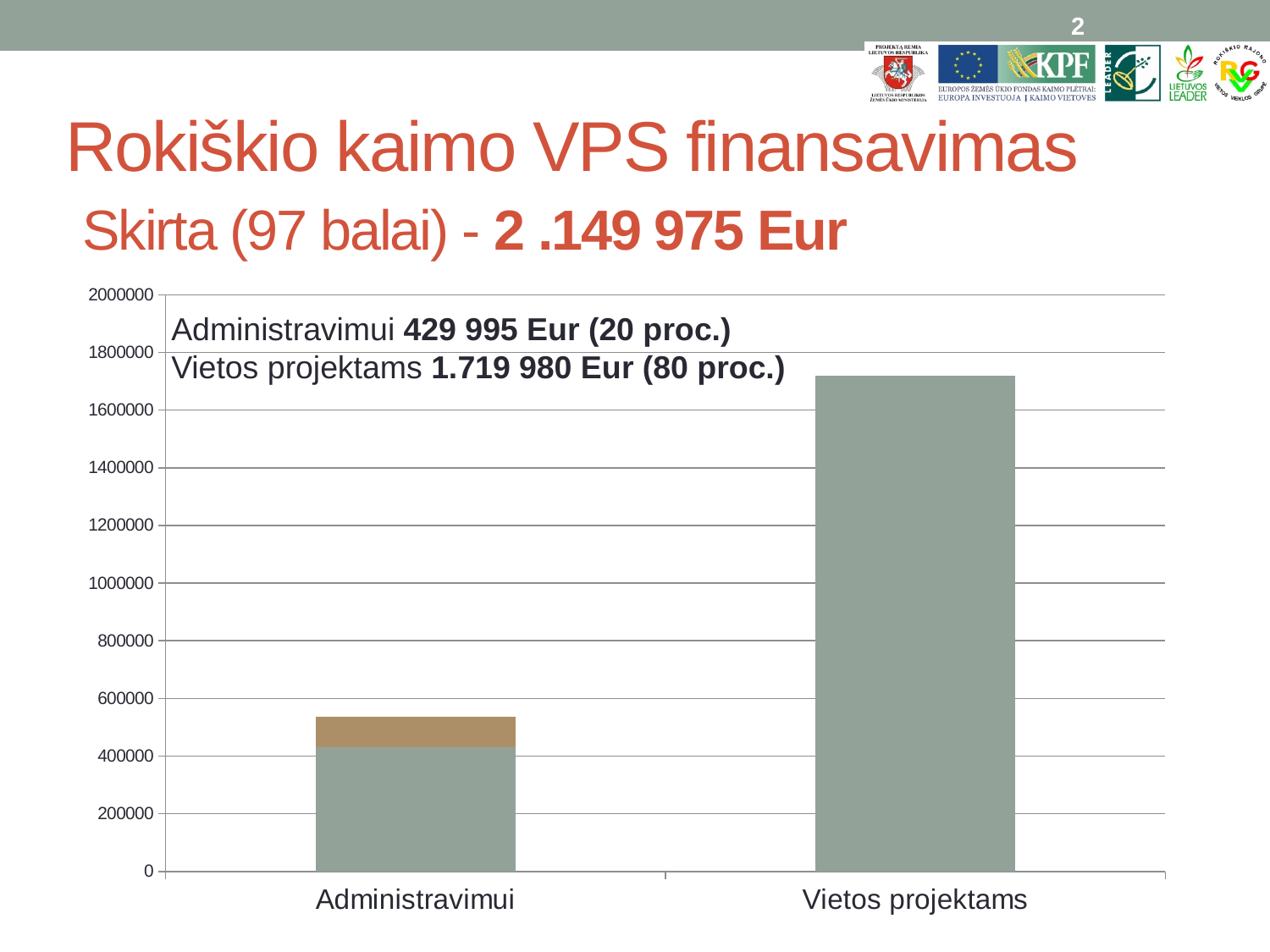
What percentage of the funding goes to Administravimui, according to the text on the chart? 20 proc. What is the highest value labelled on the vertical axis of the chart? 2000000 Which category has the highest bar in the chart? Vietos projektams Which bar is taller, Administravimui or Vietos projektams? Vietos projektams What kind of chart is shown on the slide? bar chart Is the value of the Vietos projektams bar greater or less than 1600000? greater According to the text printed on the chart, how much is allocated to Administravimui? 429 995 Eur Which category has the lowest bar in the chart? Administravimui According to the text printed on the chart, how much is allocated to Vietos projektams? 1.719 980 Eur What percentage of the funding goes to Vietos projektams, according to the text on the chart? 80 proc. Is the value of the Administravimui bar greater or less than 800000? less How many categories are shown on the x axis of the chart? 2